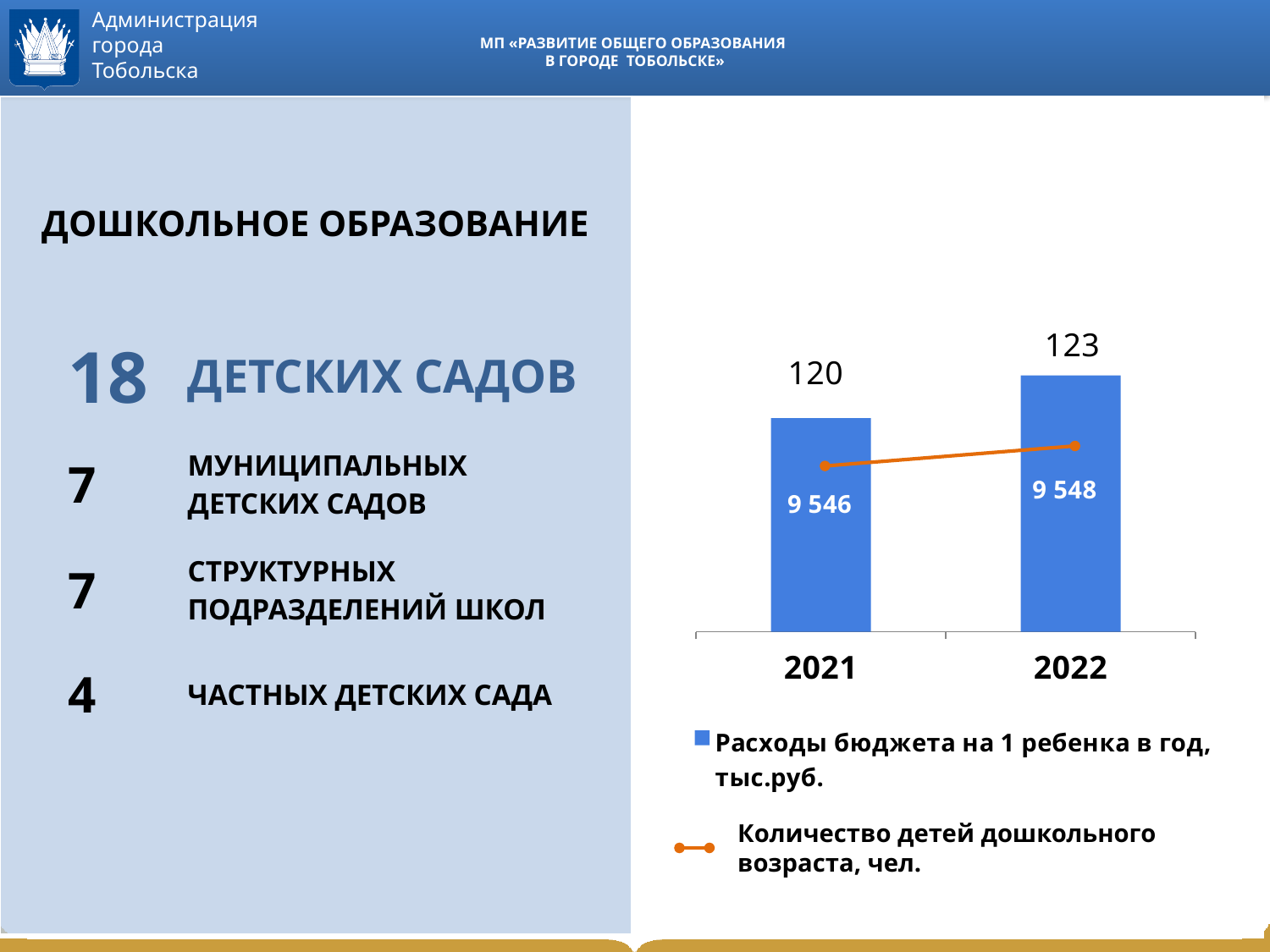
How many series does the chart legend list? 2 What is the value of 'Расходы бюджета на 1 ребенка в год, тыс.руб.' for 2021? 120 What is the value of 'Расходы бюджета на 1 ребенка в год, тыс.руб.' for 2022? 123 What is the value of 'Количество детей дошкольного возраста, чел.' for 2021? 9 546 Does 'Расходы бюджета на 1 ребенка в год, тыс.руб.' rise or fall from 2021 to 2022? Rise What is the value of 'Количество детей дошкольного возраста, чел.' for 2022? 9 548 What is the difference in 'Количество детей дошкольного возраста, чел.' between 2022 and 2021? 2 What kind of chart is shown on the slide? Combined bar and line chart Which year has the higher value for 'Расходы бюджета на 1 ребенка в год, тыс.руб.'? 2022 By how much did 'Расходы бюджета на 1 ребенка в год, тыс.руб.' change from 2021 to 2022? 3 Is the value of 'Расходы бюджета на 1 ребенка в год, тыс.руб.' larger in 2021 or in 2022? 2022 How many years are shown on the x axis of the chart? 2